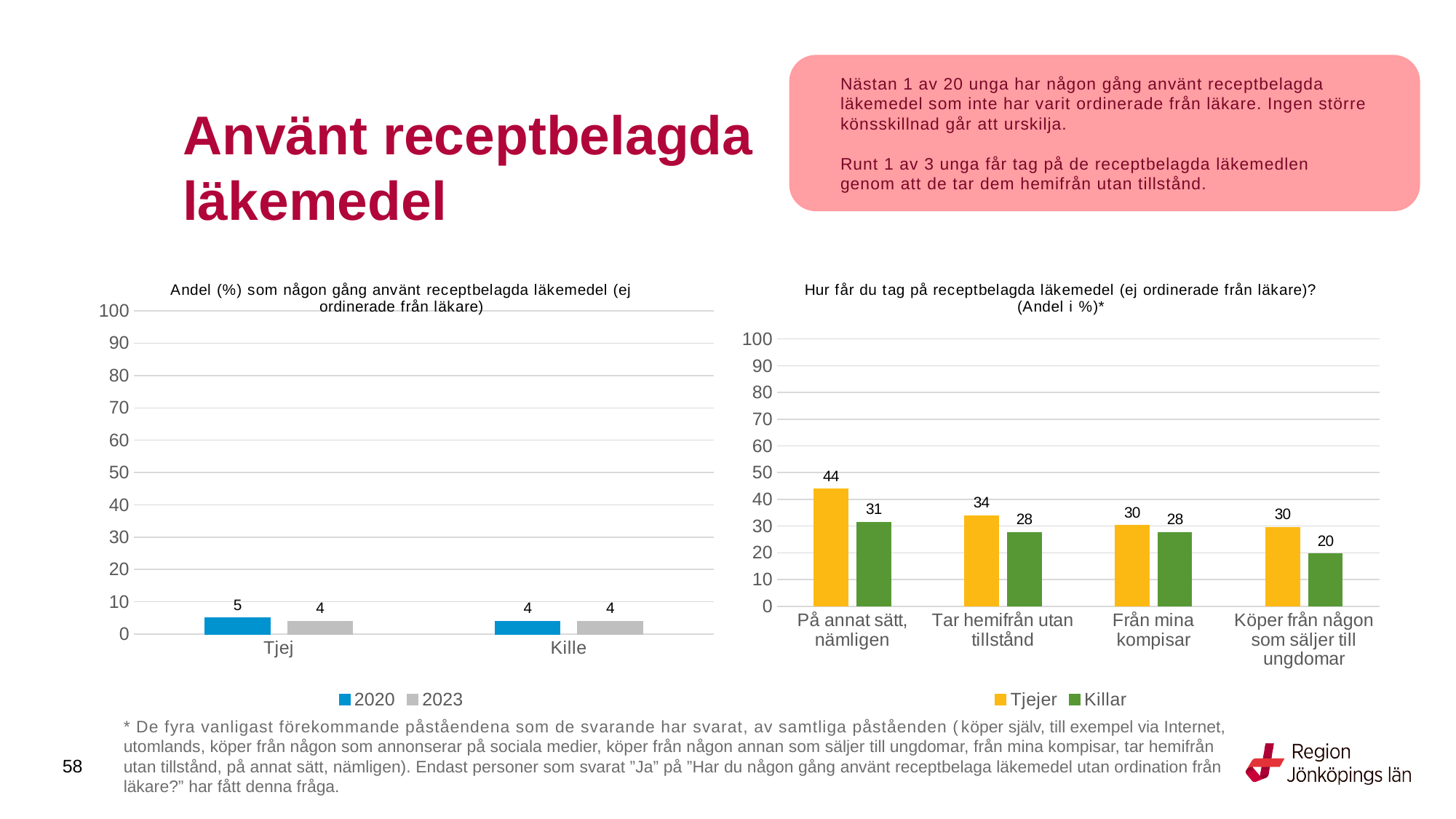
In the right chart, which category has the lowest value for Killar? Köper från någon som säljer till ungdomar In the left chart, how many series does the legend list? 2 In the right chart, what is the value for Tjejer for 'På annat sätt, nämligen'? 44 In the right chart, what is the value for Killar for 'Köper från någon som säljer till ungdomar'? 20 What type of chart is the right chart? Bar chart In the left chart, what is the difference between the 2020 and 2023 values for Tjej? 1 In the right chart, how many categories are shown on the x axis? 4 In the right chart, which category has the highest value for Tjejer? På annat sätt, nämligen In the left chart, what is the value for Kille in 2023? 4 In the right chart, what is the difference between Tjejer and Killar for 'Tar hemifrån utan tillstånd'? 6 In the right chart, which is larger for 'Från mina kompisar': Tjejer or Killar? Tjejer In the left chart, what is the value for Tjej in 2020? 5